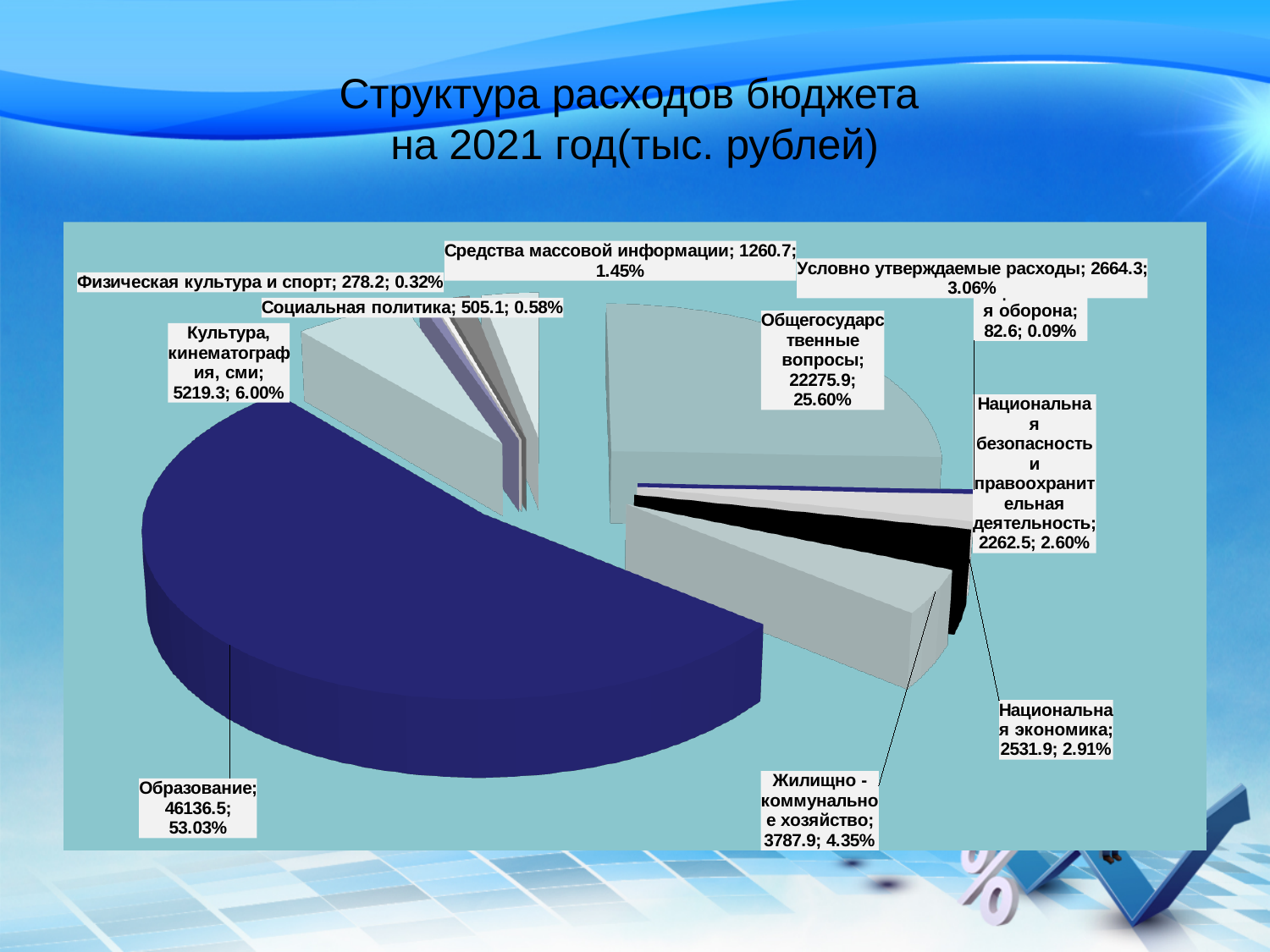
What is the value for Жилищно-коммунальное хозяйство? 3787.9 What share of the pie does Культура, кинематография, сми take? 6.00% Which category has the largest slice of the pie? Образование What kind of chart is shown on the slide? pie chart What is the value for Социальная политика? 505.1 What is the title of the chart? Структура расходов бюджета на 2021 год(тыс. рублей) What share of the pie does Средства массовой информации take? 1.45% Which is larger, the value for Национальная экономика or the value for Условно утверждаемые расходы? Условно утверждаемые расходы What is the value for Образование? 46136.5 Which category has the smallest slice of the pie? Национальная оборона What share of the pie does Общегосударственные вопросы take? 25.60% What is the difference between the values for Образование and Общегосударственные вопросы? 23860.6